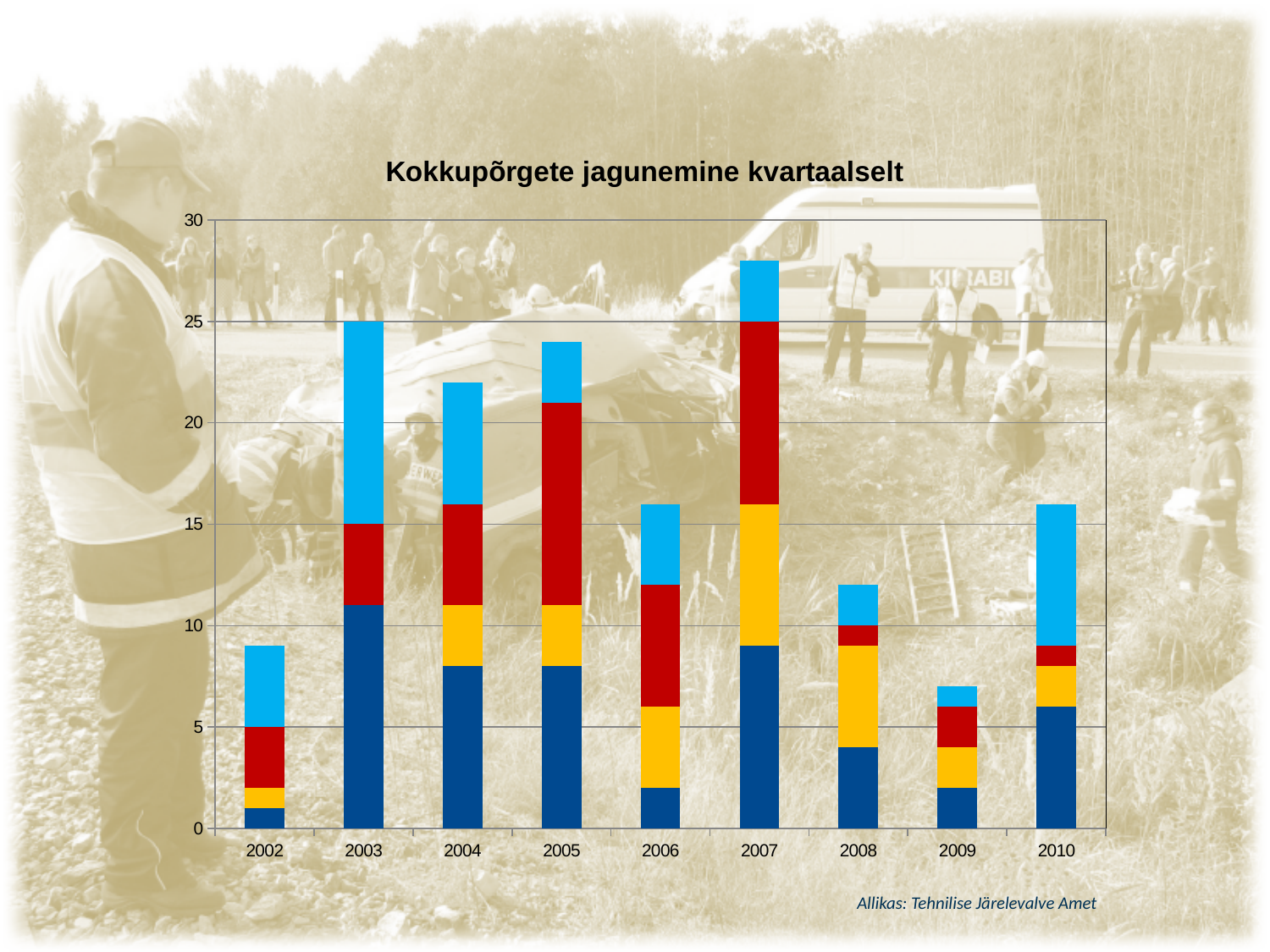
How many years are shown on the x axis of the chart? 9 What is the title of the chart? Kokkupõrgete jagunemine kvartaalselt Which year has the taller stacked bar, 2008 or 2009? 2008 Do the bar totals rise or fall from 2007 to 2009? fall Which year has the taller stacked bar, 2003 or 2004? 2003 Is the total for 2002 greater or less than 10? less What kind of chart is shown on the slide? stacked bar chart Which year has the tallest stacked bar? 2007 Is the total for 2007 greater or less than 25? greater Is the total for 2009 greater or less than 10? less Which year has the shortest stacked bar? 2009